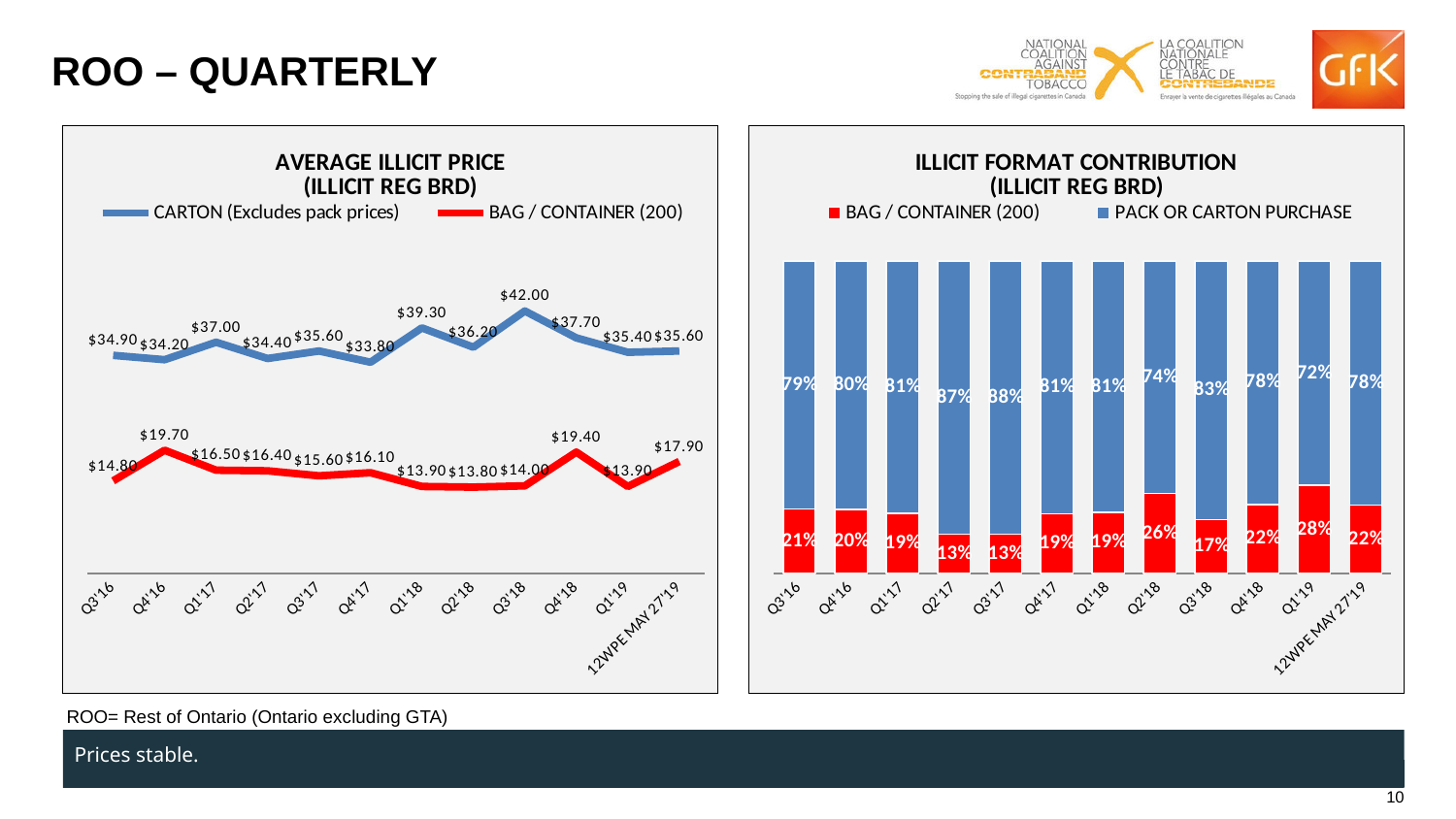
What kind of chart is the AVERAGE ILLICIT PRICE chart? Line chart In the ILLICIT FORMAT CONTRIBUTION chart, what is the PACK OR CARTON PURCHASE share for Q3'17? 88% In the AVERAGE ILLICIT PRICE chart, how many series does the legend list? 2 In the AVERAGE ILLICIT PRICE chart, what is the CARTON value for Q3'18? $42.00 In the AVERAGE ILLICIT PRICE chart, what is the BAG / CONTAINER (200) value for Q4'16? $19.70 In the AVERAGE ILLICIT PRICE chart, which quarter has the highest CARTON price? Q3'18 In the ILLICIT FORMAT CONTRIBUTION chart, how many quarters are shown on the x axis? 12 In the ILLICIT FORMAT CONTRIBUTION chart, what is the BAG / CONTAINER (200) share for Q1'19? 28% In the AVERAGE ILLICIT PRICE chart, what is the difference between the CARTON and BAG / CONTAINER (200) prices for 12WPE MAY 27'19? $17.70 In the ILLICIT FORMAT CONTRIBUTION chart, which series is shown in red? BAG / CONTAINER (200) In the AVERAGE ILLICIT PRICE chart, which quarter has the lowest BAG / CONTAINER (200) price? Q2'18 In the ILLICIT FORMAT CONTRIBUTION chart, which quarter has the lowest PACK OR CARTON PURCHASE share? Q1'19